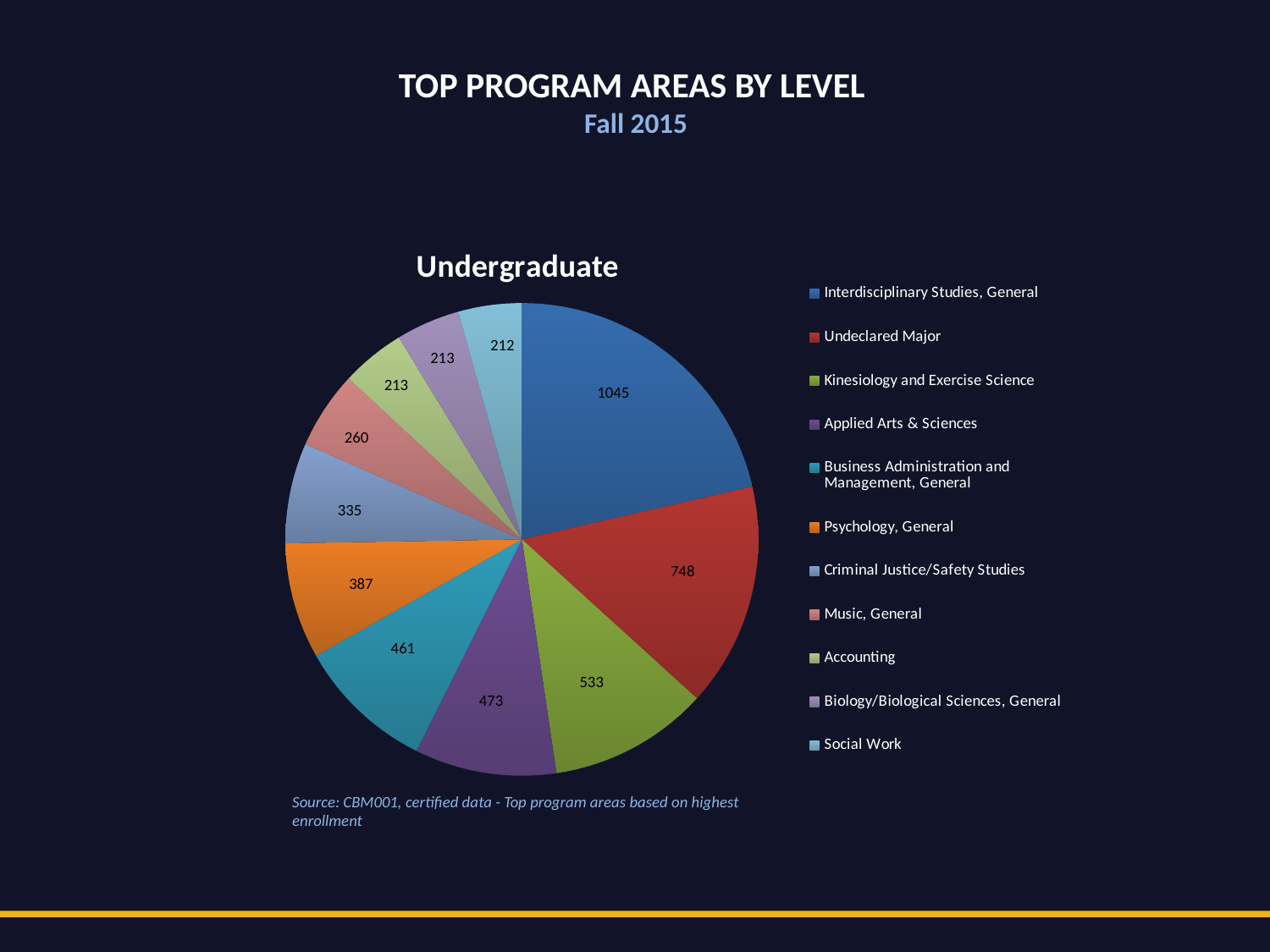
Which legend entry is listed last in the Undergraduate pie chart? Social Work What is the value for Psychology, General in the Undergraduate pie chart? 387 Which program area has the largest slice in the Undergraduate pie chart? Interdisciplinary Studies, General What is the title of the chart on the slide? Undergraduate What type of chart is shown on the slide? Pie chart What is the difference between the values for Kinesiology and Exercise Science and Applied Arts & Sciences? 60 What is the value for Undeclared Major in the Undergraduate pie chart? 748 Which is larger: Business Administration and Management, General or Criminal Justice/Safety Studies? Business Administration and Management, General What is the value for Music, General in the Undergraduate pie chart? 260 What is the difference between the values for Interdisciplinary Studies, General and Undeclared Major? 297 What is the value for Interdisciplinary Studies, General in the Undergraduate pie chart? 1045 How many program areas are shown in the Undergraduate pie chart? 11